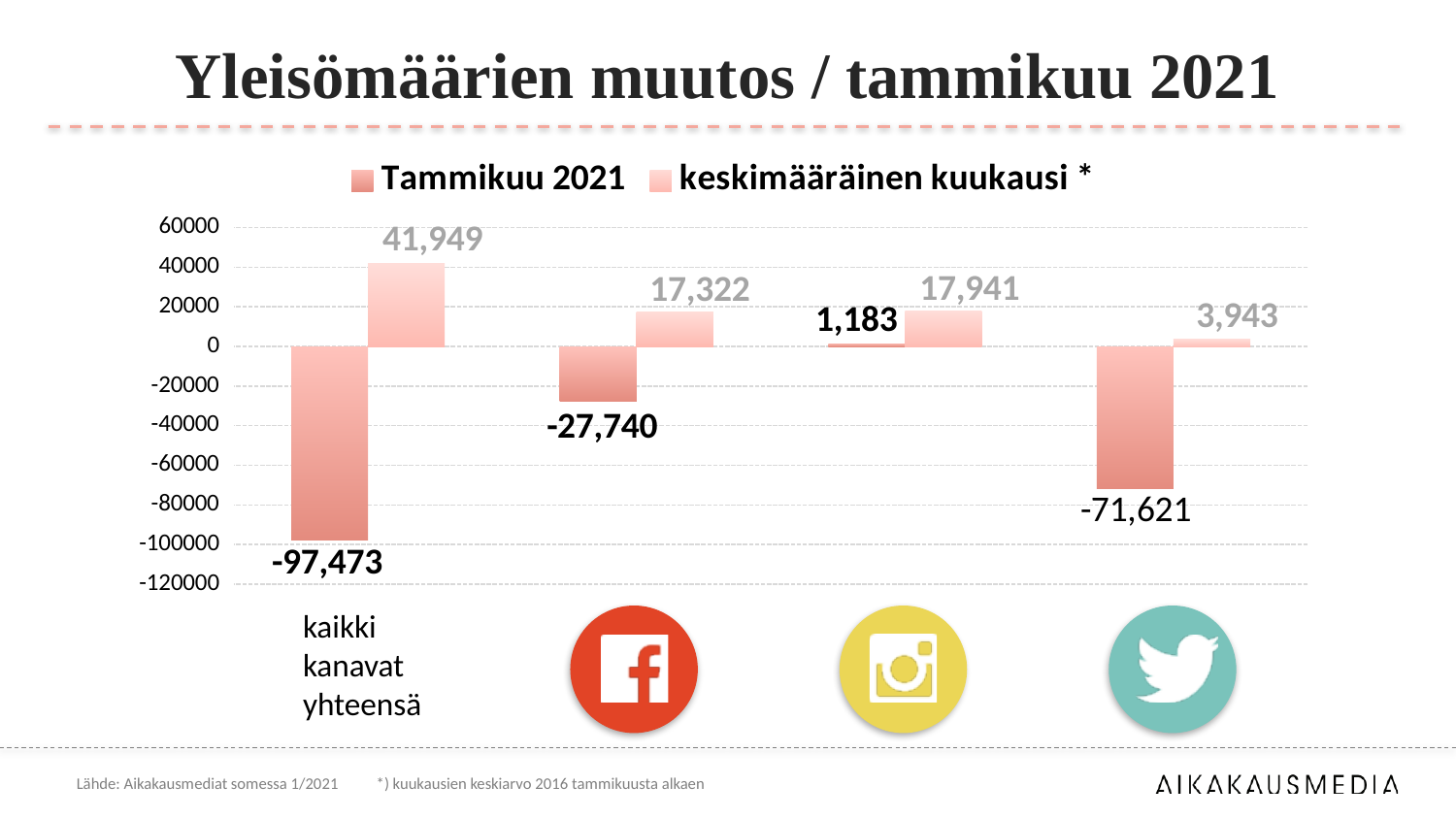
What is the Tammikuu 2021 value for the Facebook category (second from the left)? -27,740 Which category has the highest "keskimääräinen kuukausi *" value? kaikki kanavat yhteensä How many series does the legend list? 2 For the Instagram category, which series has the larger value: Tammikuu 2021 or keskimääräinen kuukausi *? keskimääräinen kuukausi * What is the Tammikuu 2021 value for "kaikki kanavat yhteensä"? -97,473 What is the Tammikuu 2021 value for the Instagram category (third from the left)? 1,183 Which category has the lowest Tammikuu 2021 value? kaikki kanavat yhteensä What kind of chart is shown on the slide? bar chart For the Facebook category, what is the difference between the "keskimääräinen kuukausi *" value (17,322) and the Tammikuu 2021 value (-27,740)? 45,062 How many categories are shown on the x axis of the chart? 4 What is the "keskimääräinen kuukausi *" value for the Twitter category (rightmost)? 3,943 What is the "keskimääräinen kuukausi *" value for "kaikki kanavat yhteensä"? 41,949